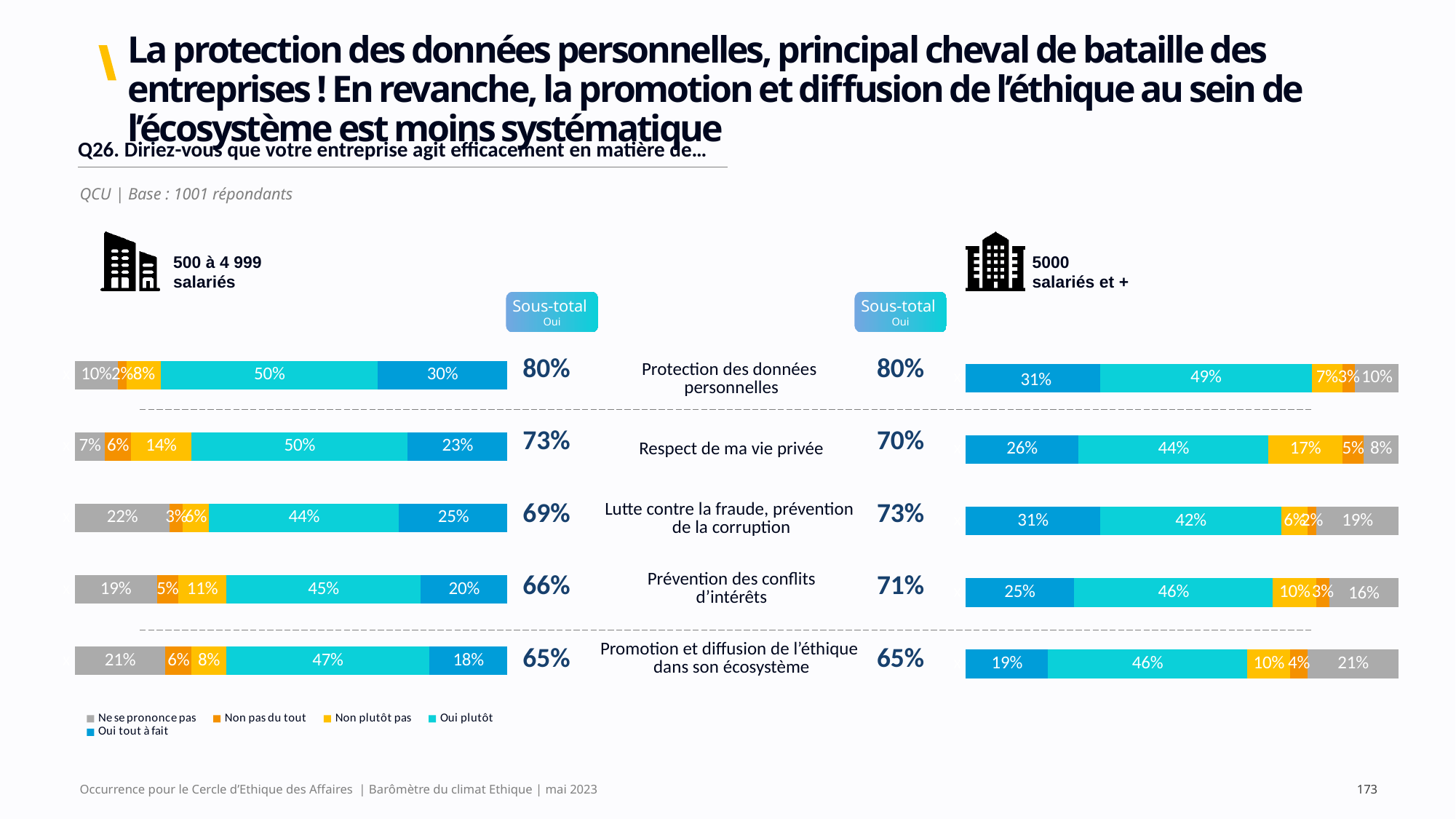
How many categories are shown in the chart for '500 à 4 999 salariés'? 5 What kind of chart is used for '5000 salariés et +'? Stacked bar chart In the chart for '5000 salariés et +', what is the 'Non plutôt pas' value for 'Prévention des conflits d'intérêts'? 10% In the chart for '5000 salariés et +', which category has the lowest 'Oui tout à fait' value? Promotion et diffusion de l'éthique dans son écosystème In the chart for '5000 salariés et +', what is the 'Oui plutôt' value for 'Respect de ma vie privée'? 44% What is the 'Sous-total Oui' for 'Prévention des conflits d'intérêts' in the chart for '5000 salariés et +'? 71% How many series does the legend list? 5 In the chart for '500 à 4 999 salariés', what is the difference between the 'Oui plutôt' values for 'Respect de ma vie privée' and 'Lutte contre la fraude, prévention de la corruption'? 6% In the chart for '5000 salariés et +', is the 'Ne se prononce pas' value larger for 'Lutte contre la fraude, prévention de la corruption' or for 'Respect de ma vie privée'? Lutte contre la fraude, prévention de la corruption In the chart for '500 à 4 999 salariés', what is the 'Oui tout à fait' value for 'Protection des données personnelles'? 30% In the chart for '500 à 4 999 salariés', which category has the highest 'Oui tout à fait' value? Protection des données personnelles In the chart for '500 à 4 999 salariés', what is the 'Ne se prononce pas' value for 'Lutte contre la fraude, prévention de la corruption'? 22%